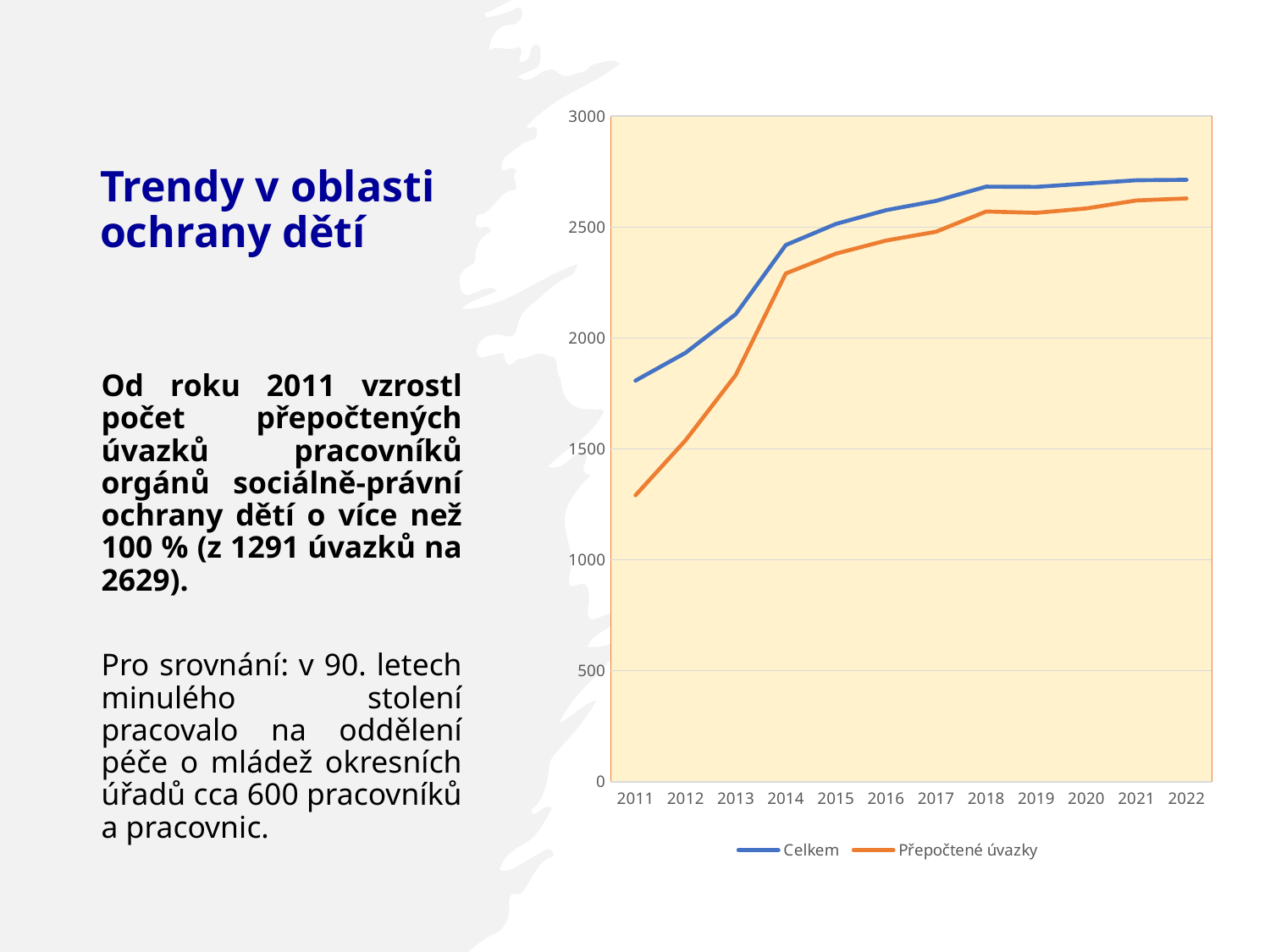
Do the values of the Přepočtené úvazky series generally rise or fall from 2011 to 2022? rise Which series is drawn in orange in the chart? Přepočtené úvazky Is the value for Přepočtené úvazky in 2011 greater or less than 1500? less How many years are shown on the x axis of the chart? 12 How many series does the chart legend list? 2 Is the value for Celkem in 2022 greater or less than 2500? greater Which year has the lowest value for the Přepočtené úvazky series? 2011 Is the value for Celkem in 2011 greater or less than 1500? greater In 2011, which series has the larger value, Celkem or Přepočtené úvazky? Celkem Which year has the lowest value for the Celkem series? 2011 What kind of chart is shown on the slide? line chart